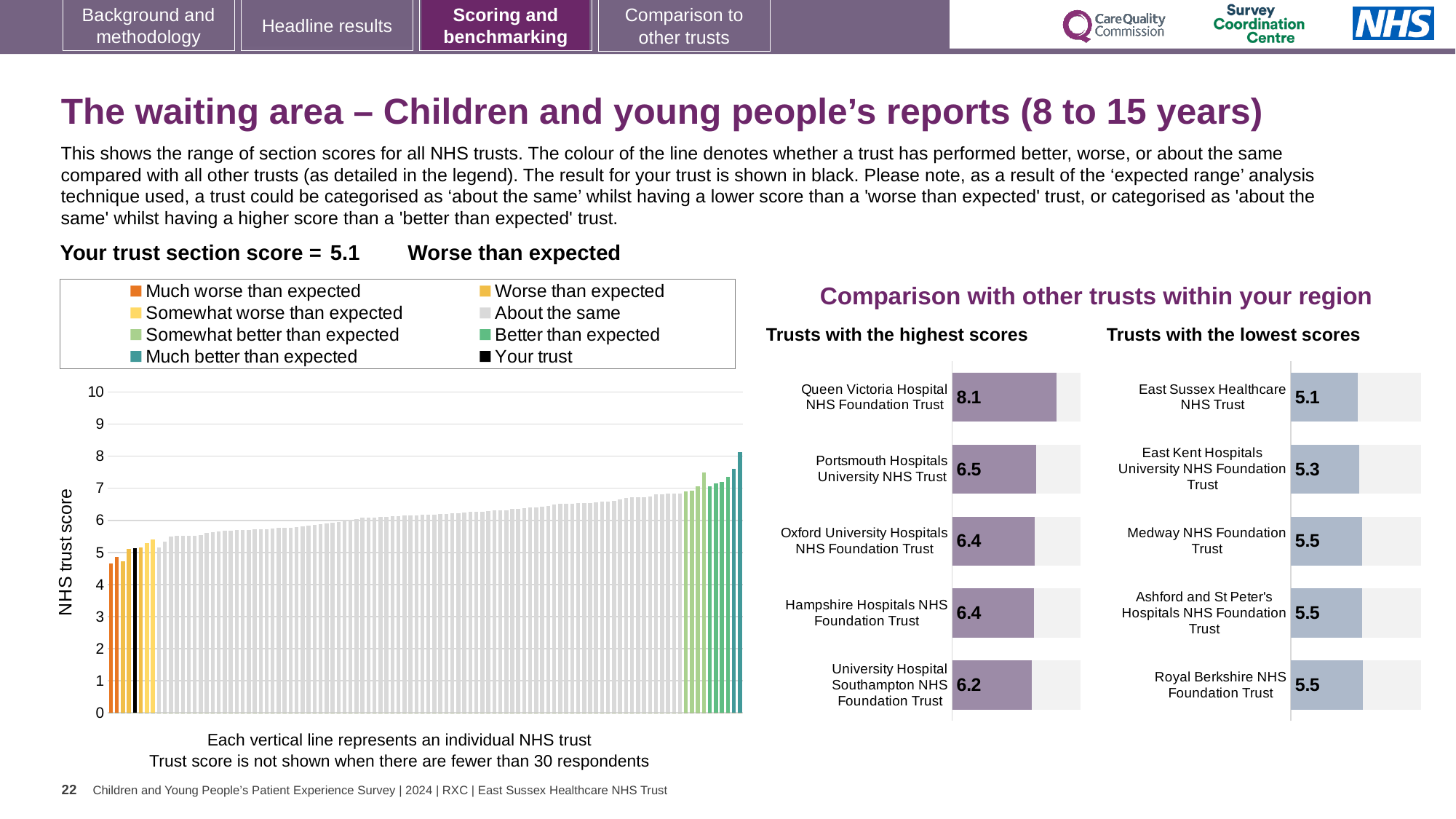
How many entries does the legend of the 'NHS trust score' chart on the left list? 8 In the 'Trusts with the lowest scores' chart, what is the score for East Kent Hospitals University NHS Foundation Trust? 5.3 In the 'Trusts with the highest scores' chart, which has the larger score: Portsmouth Hospitals University NHS Trust or Oxford University Hospitals NHS Foundation Trust? Portsmouth Hospitals University NHS Trust In the 'Trusts with the lowest scores' chart, how much higher is East Kent Hospitals University NHS Foundation Trust's score than East Sussex Healthcare NHS Trust's score? 0.2 In the 'Trusts with the highest scores' chart, what is the score for Queen Victoria Hospital NHS Foundation Trust? 8.1 In the 'Trusts with the highest scores' chart, which trust has the highest score? Queen Victoria Hospital NHS Foundation Trust What kind of chart is the 'NHS trust score' chart on the left of the slide? Bar chart In the 'Trusts with the lowest scores' chart, which trust has the lowest score? East Sussex Healthcare NHS Trust In the 'Trusts with the highest scores' chart, what is the difference between the scores of Queen Victoria Hospital NHS Foundation Trust and Portsmouth Hospitals University NHS Trust? 1.6 In the 'NHS trust score' chart on the left, do the bar values rise or fall from left to right? Rise How many trusts are shown in the 'Trusts with the lowest scores' chart? 5 In the 'Trusts with the highest scores' chart, what is the score for University Hospital Southampton NHS Foundation Trust? 6.2